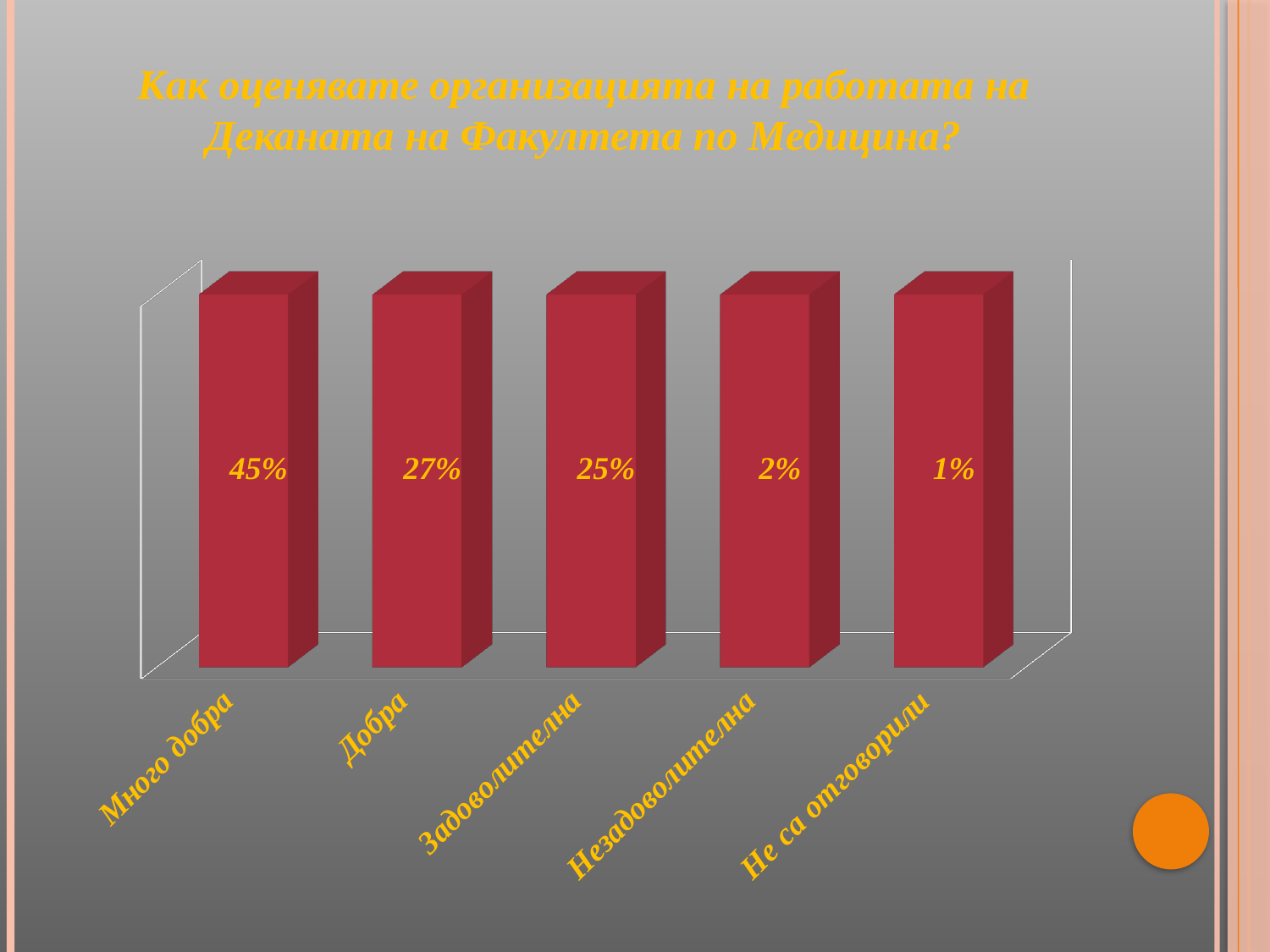
How many categories are shown in the chart? 5 What is the value for Не са отговорили? 1% What kind of chart is shown on the slide? bar chart Which is larger, the value for Добра or the value for Задоволителна? Добра What is the value for Задоволителна? 25% Which category has the highest value? Много добра What is the value for Добра? 27% Which category has the lowest value? Не са отговорили What is the difference between the values for Много добра and Добра? 18% What is the value for Много добра? 45% Do the labelled values rise or fall from left to right along the x axis? fall What is the value for Незадоволителна? 2%